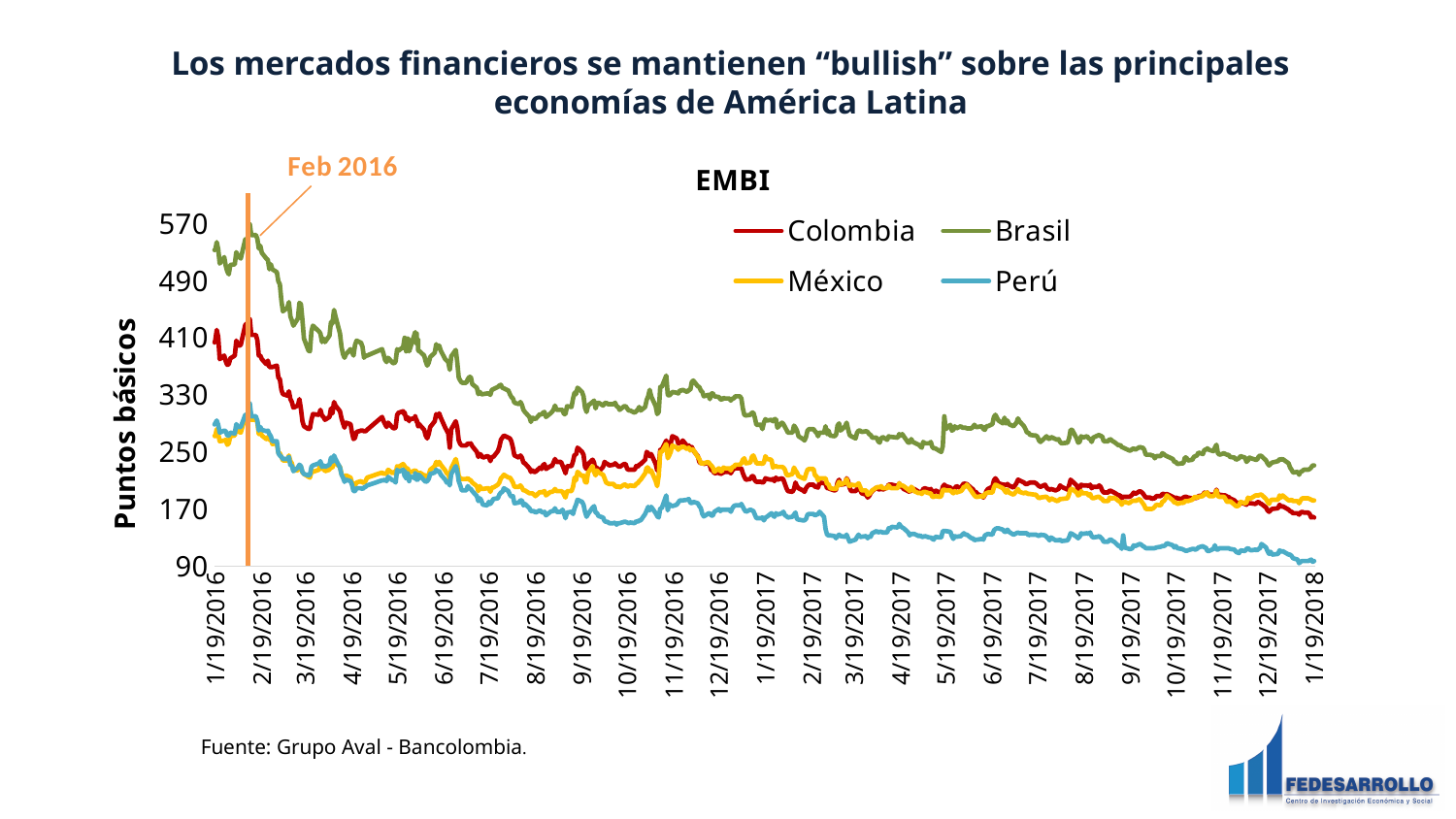
Is the value for Perú at 1/19/2018 greater or less than 170? less Does the Brasil series rise or fall from 2/19/2016 to 1/19/2018? fall What is the title of the chart? EMBI Is the value for Brasil at 1/19/2018 greater or less than 170? greater What is the label of the vertical axis? Puntos básicos Which series has the highest values throughout the EMBI chart? Brasil Which series has the lowest value at the end of the EMBI chart (1/19/2018)? Perú Is the peak value for Brasil in February 2016 greater or less than 490? greater How many series does the legend of the EMBI chart list? 4 At 1/19/2018, which series has the larger value, Brasil or Perú? Brasil What kind of chart is shown on the slide? line chart